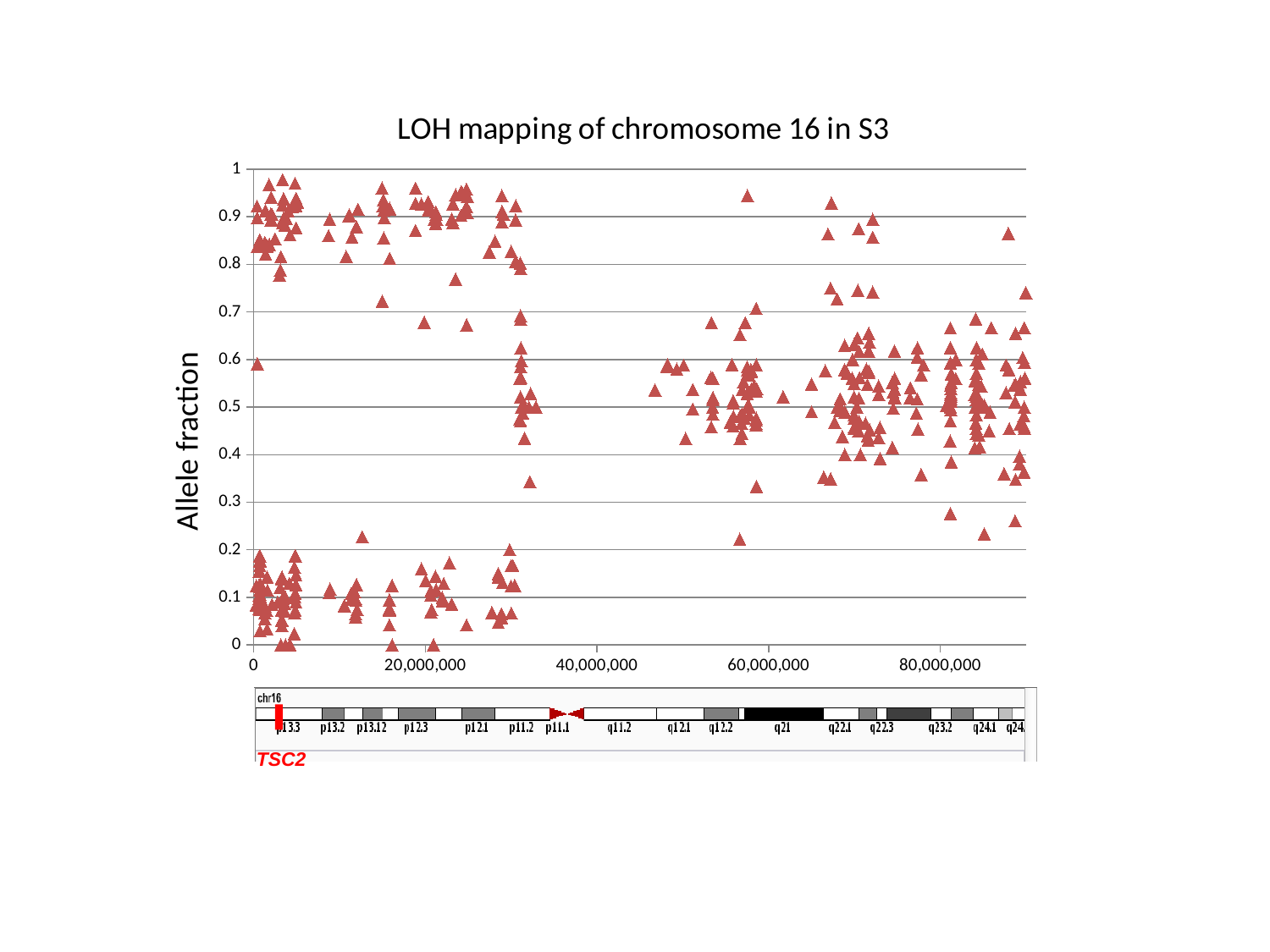
What kind of chart is shown on the slide? scatter chart What is the label on the y axis of the chart? Allele fraction Is the highest allele fraction plotted on the chart greater or less than 0.9? greater What is the title of the chart? LOH mapping of chromosome 16 in S3 Is the lowest allele fraction plotted on the chart greater or less than 0.1? less